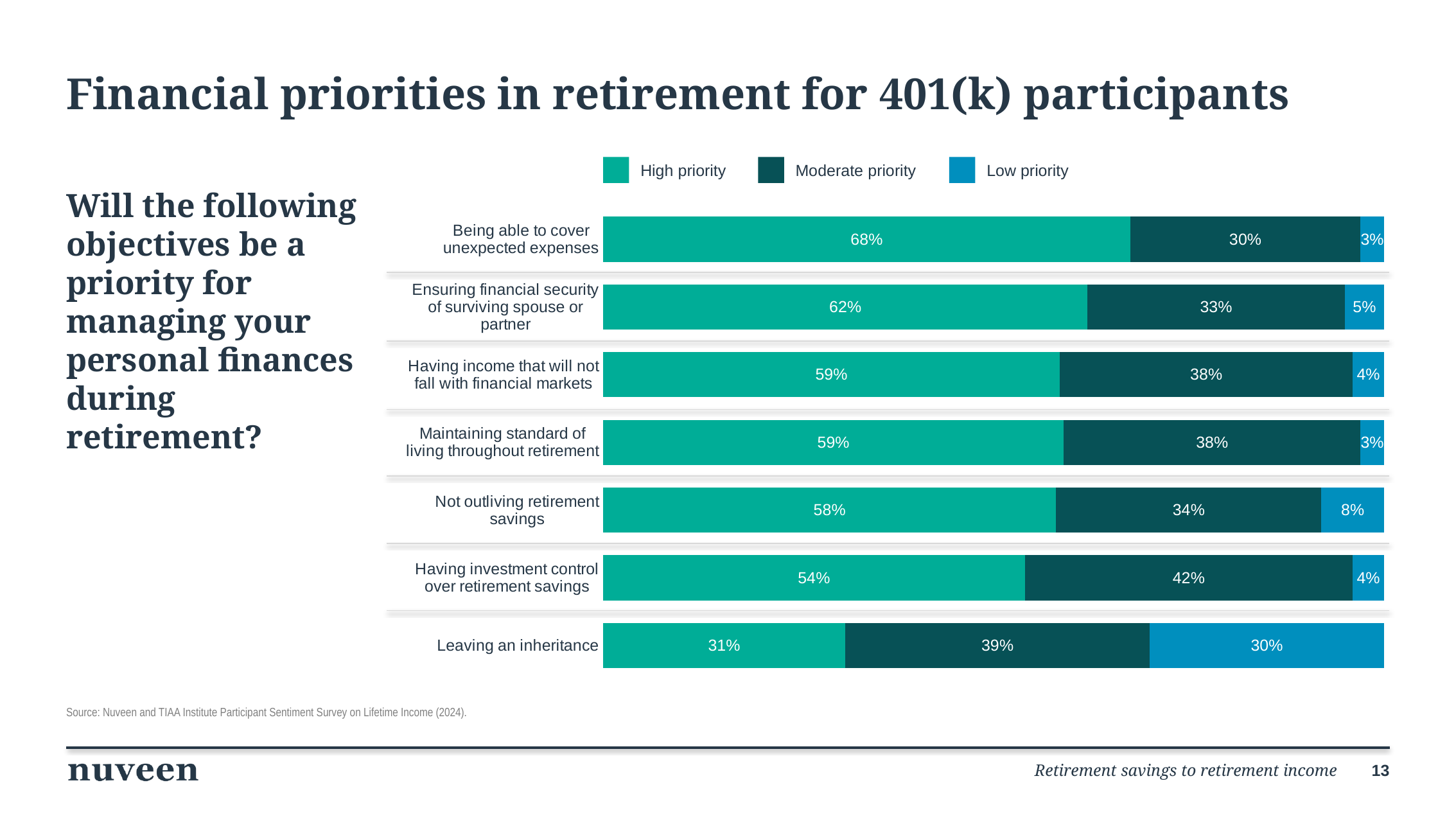
Which objective has the lowest High priority percentage? Leaving an inheritance What is the total of the three segments for "Not outliving retirement savings"? 100% How many objectives are shown in the chart? 7 What is the difference in High priority percentage between "Being able to cover unexpected expenses" and "Leaving an inheritance"? 37 percentage points How many series does the legend list? 3 What kind of chart is shown on the slide? Stacked bar chart What is the Moderate priority value for "Having investment control over retirement savings"? 42% What is the Low priority value for "Leaving an inheritance"? 30% Which objective has the highest High priority percentage? Being able to cover unexpected expenses Which objective has the highest Low priority percentage? Leaving an inheritance Which has a larger Moderate priority value: "Having investment control over retirement savings" or "Leaving an inheritance"? Having investment control over retirement savings What percentage of participants rated "Being able to cover unexpected expenses" as a high priority? 68%